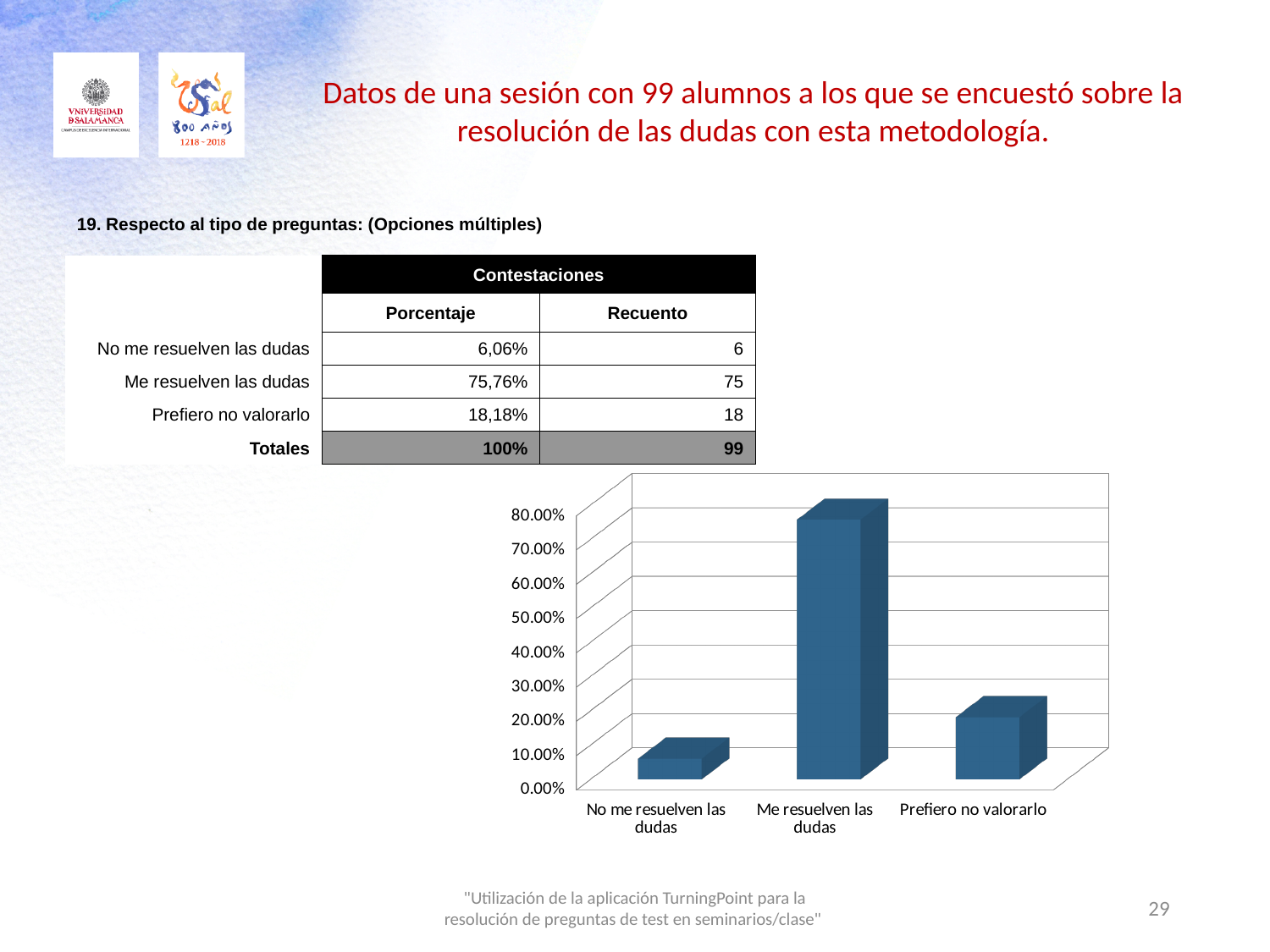
Is the value for Prefiero no valorarlo greater or less than 30.00%? less Is the value for Me resuelven las dudas greater or less than 70.00%? greater What is the highest value labelled on the vertical axis of the chart? 80.00% Which category has the highest bar in the chart? Me resuelven las dudas Using the percentages in the table, what is the difference between Me resuelven las dudas and Prefiero no valorarlo? 57,58% Is the value for No me resuelven las dudas greater or less than 10.00%? less According to the table on the slide, what is the count (Recuento) for Prefiero no valorarlo? 18 Which is larger in the chart, the value for Prefiero no valorarlo or the value for No me resuelven las dudas? Prefiero no valorarlo Which category has the lowest bar in the chart? No me resuelven las dudas According to the table on the slide, what percentage corresponds to Me resuelven las dudas? 75,76% What kind of chart is shown on the slide? bar chart How many categories are shown on the x axis of the chart? 3